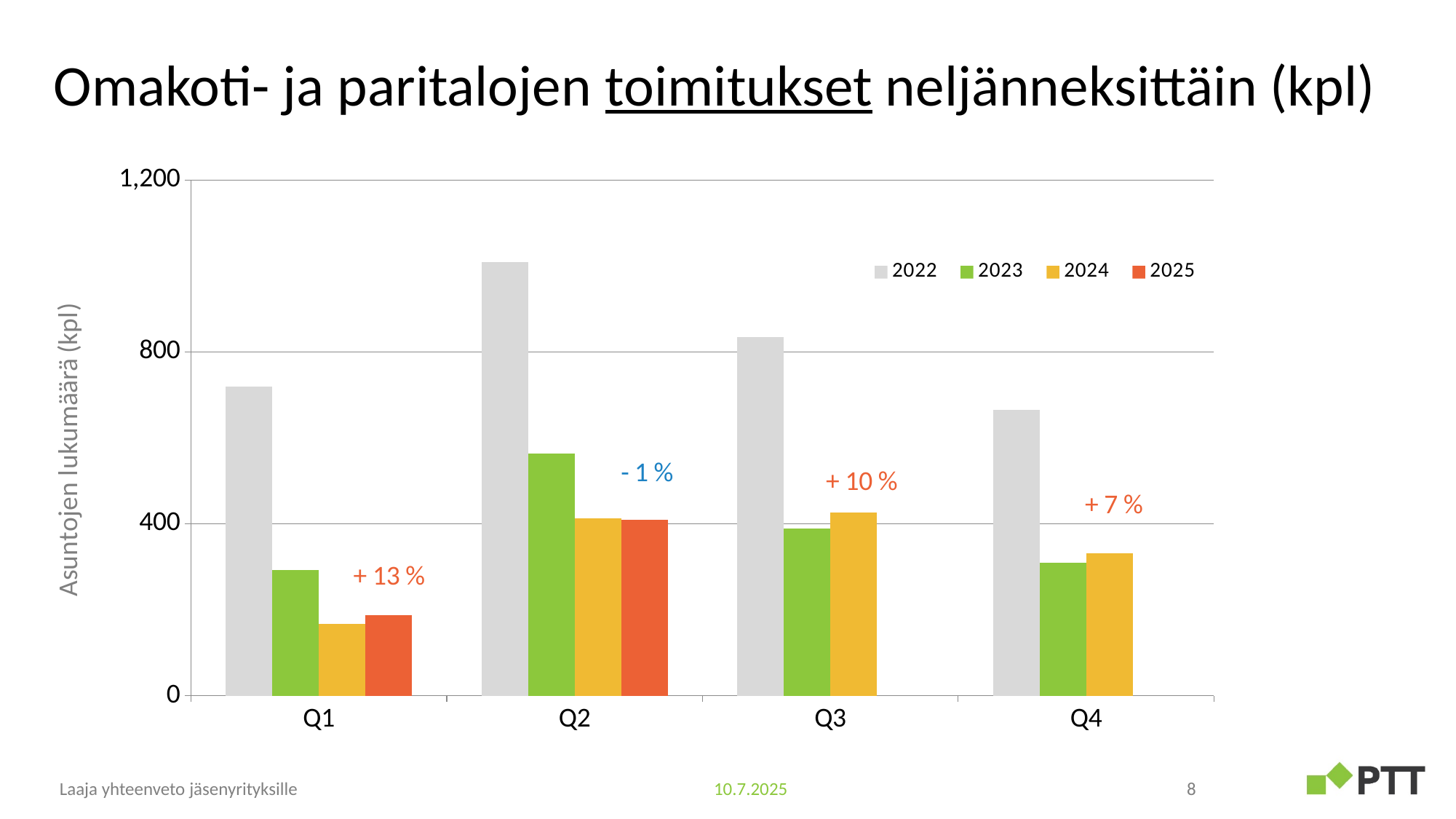
Is the 2022 value for Q1 greater or less than 800? less How many quarters are shown on the x axis? 4 What kind of chart is shown on the slide? bar chart Which quarter has the lowest 2024 value? Q1 Is the 2023 value for Q2 greater or less than 400? greater Is the 2022 value for Q2 greater or less than 800? greater How many series does the legend list? 4 In which quarter is the 2022 value highest? Q2 What is the title of the y axis? Asuntojen lukumäärä (kpl) In Q1, which is larger: the 2023 value or the 2024 value? 2023 What percentage change is annotated above the Q1 bars? + 13 %